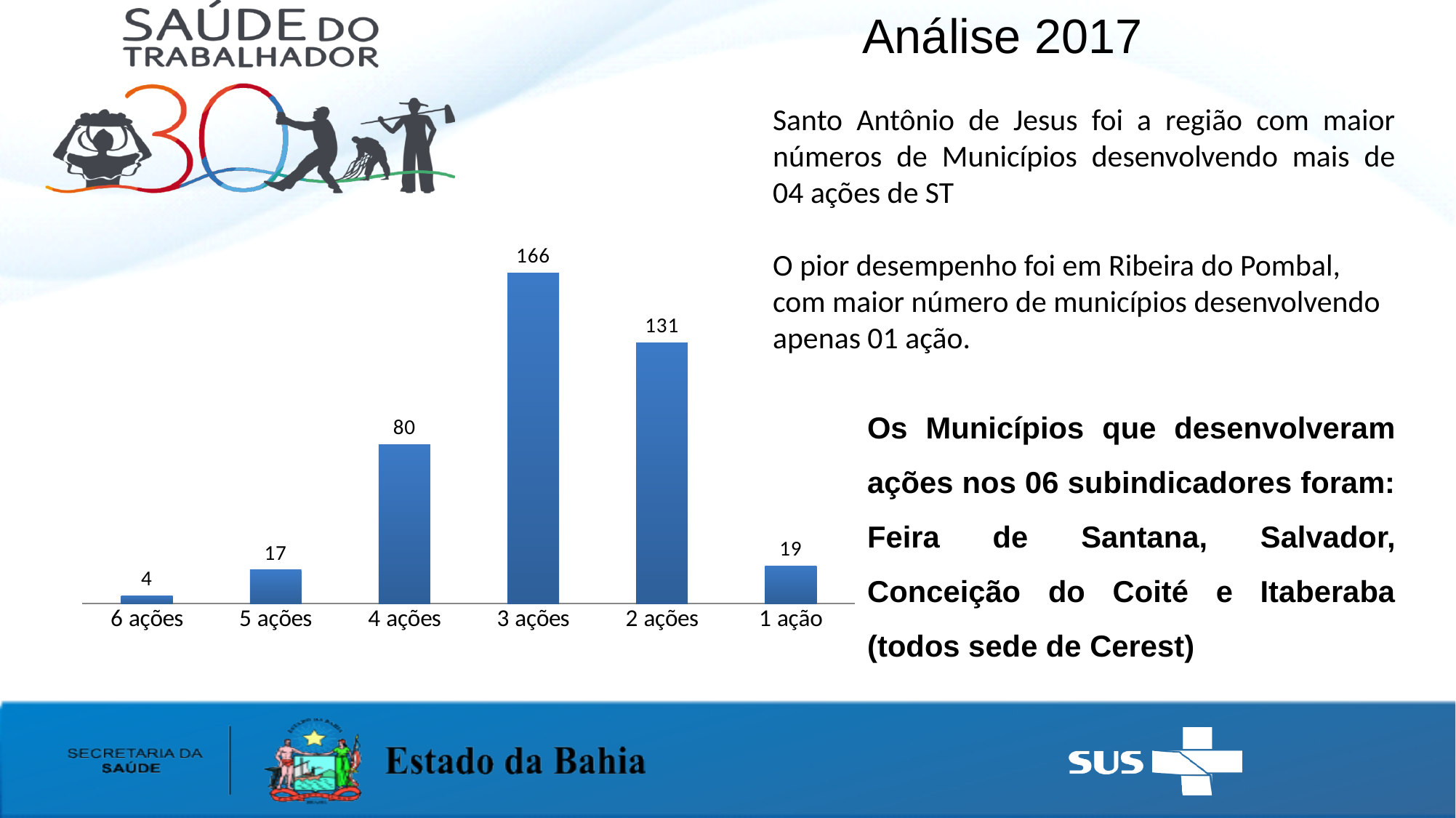
Which is larger, the value for "4 ações" or the value for "2 ações"? 2 ações What is the value for the "1 ação" category? 19 Which category has the highest value? 3 ações What is the total of all the bar values in the chart? 417 What is the difference between the values for "3 ações" and "2 ações"? 35 What is the value for the "6 ações" category? 4 What is the difference between the values for "1 ação" and "5 ações"? 2 What is the value for the "4 ações" category? 80 How many categories are shown on the x axis of the chart? 6 What kind of chart is shown on the slide? bar chart Which category has the lowest value? 6 ações What is the value for the "3 ações" category? 166